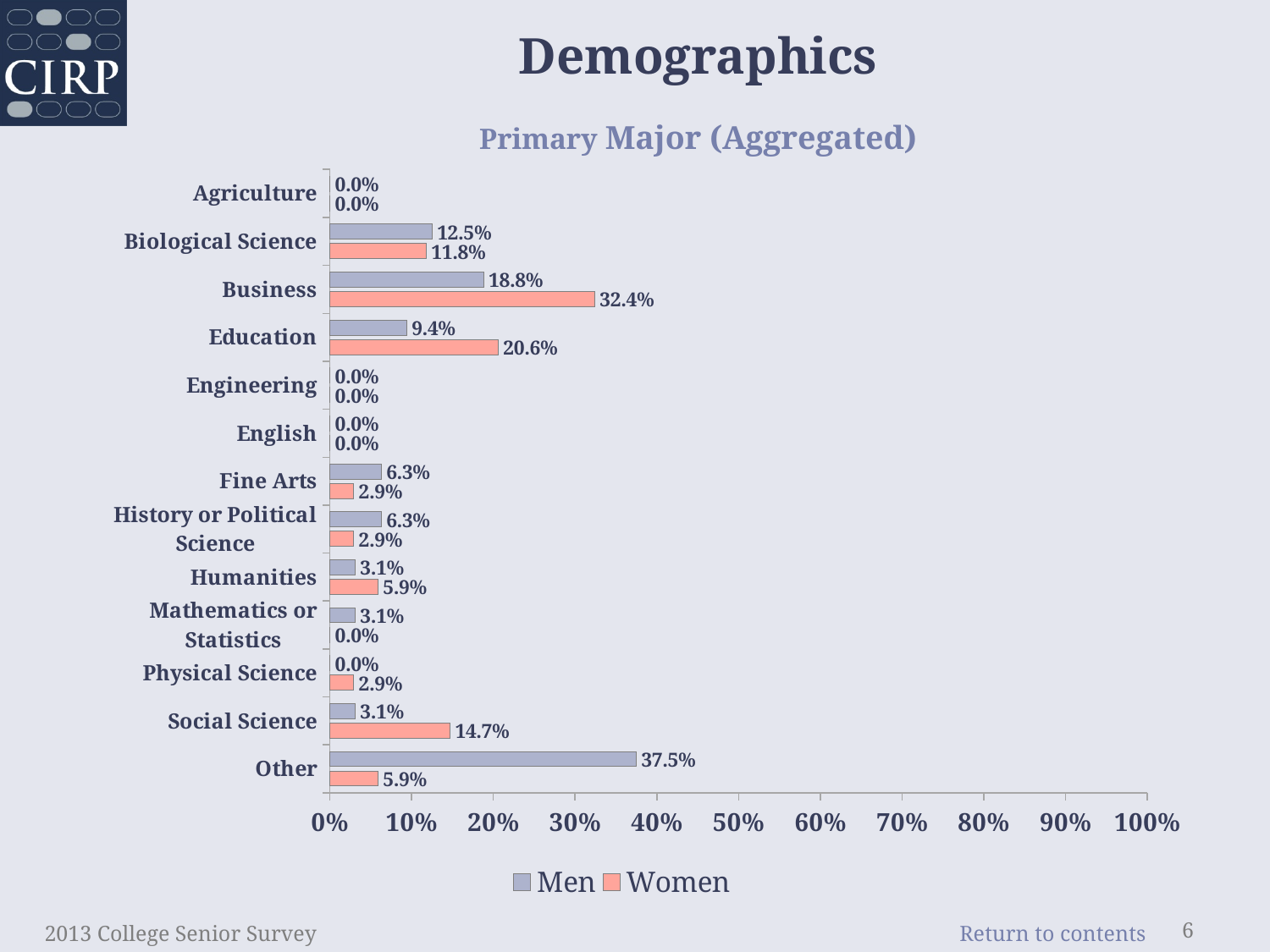
How many categories are shown on the chart? 13 What is the difference between the Women and Men values for Business? 13.6% What is the value for Men in Education? 9.4% Which is larger, the Men value for Biological Science or the Women value for Biological Science? Men What is the value for Women in Business? 32.4% How many series does the legend list? 2 What is the value for Women in Social Science? 14.7% Is the value for Men in Other greater or less than 30%? greater Which category has the highest value for Women? Business Which category has the highest value for Men? Other What kind of chart is shown on the slide? Bar chart What is the value for Men in Other? 37.5%